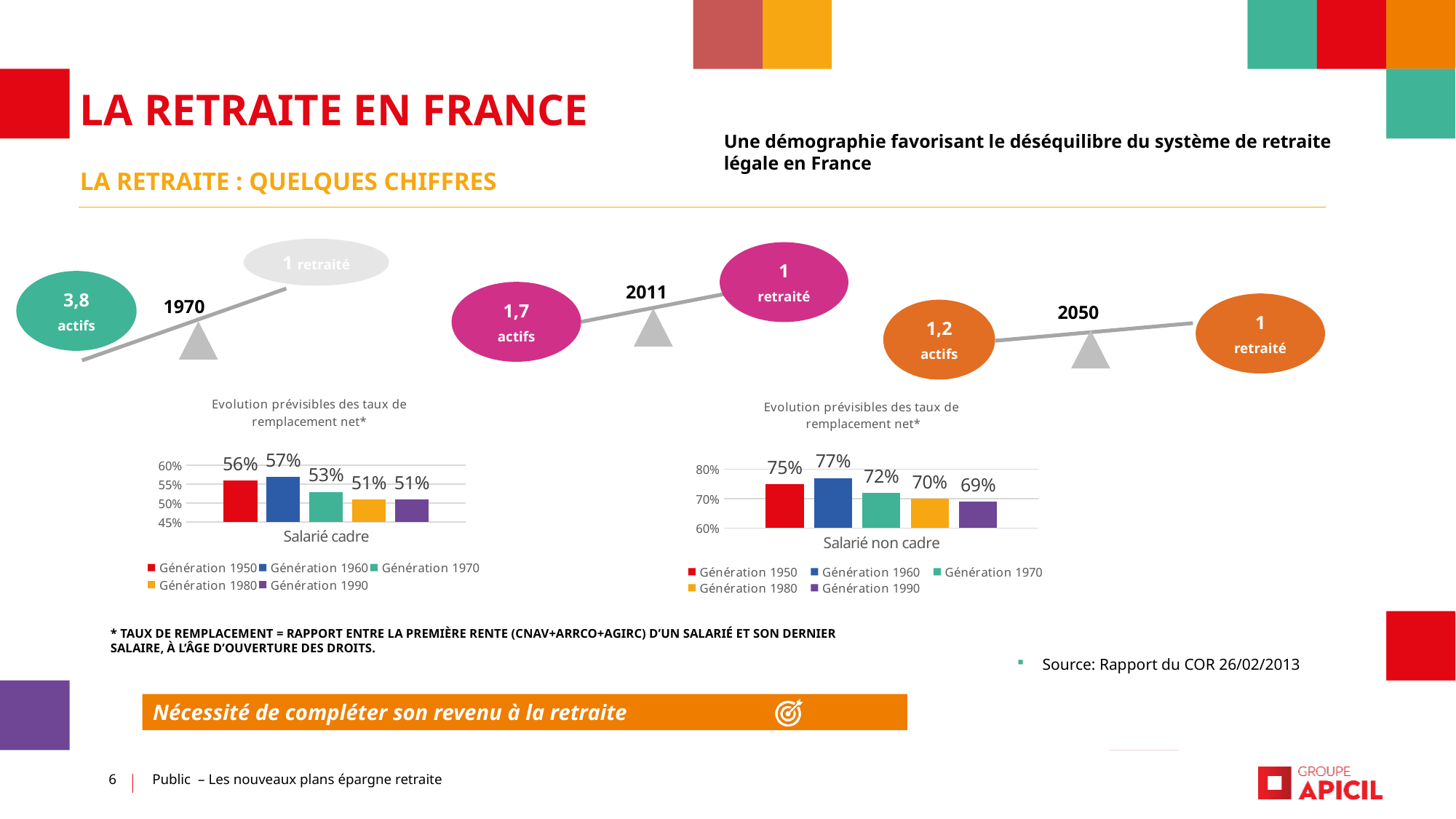
In the right chart (Salarié non cadre), what is the difference between Génération 1950 and Génération 1980? 5% In the left chart (Salarié cadre), what colour is the bar for Génération 1950? Red In the right chart (Salarié non cadre), which generation has the lowest value? Génération 1990 In the right chart (Salarié non cadre), which generation has the highest value? Génération 1960 In the left chart (Salarié cadre), which generation has the highest value? Génération 1960 How many series does the legend of the left chart (Salarié cadre) list? 5 In the left chart (Salarié cadre), what is the difference between Génération 1960 and Génération 1990? 6% In the left chart (Salarié cadre), what is the value for Génération 1960? 57% In the right chart (Salarié non cadre), what is the value for Génération 1990? 69% In the right chart (Salarié non cadre), which is larger, Génération 1970 or Génération 1980? Génération 1970 What kind of chart is the right chart (Salarié non cadre)? Bar chart In the right chart (Salarié non cadre), do the values generally rise or fall from Génération 1960 to Génération 1990? Fall